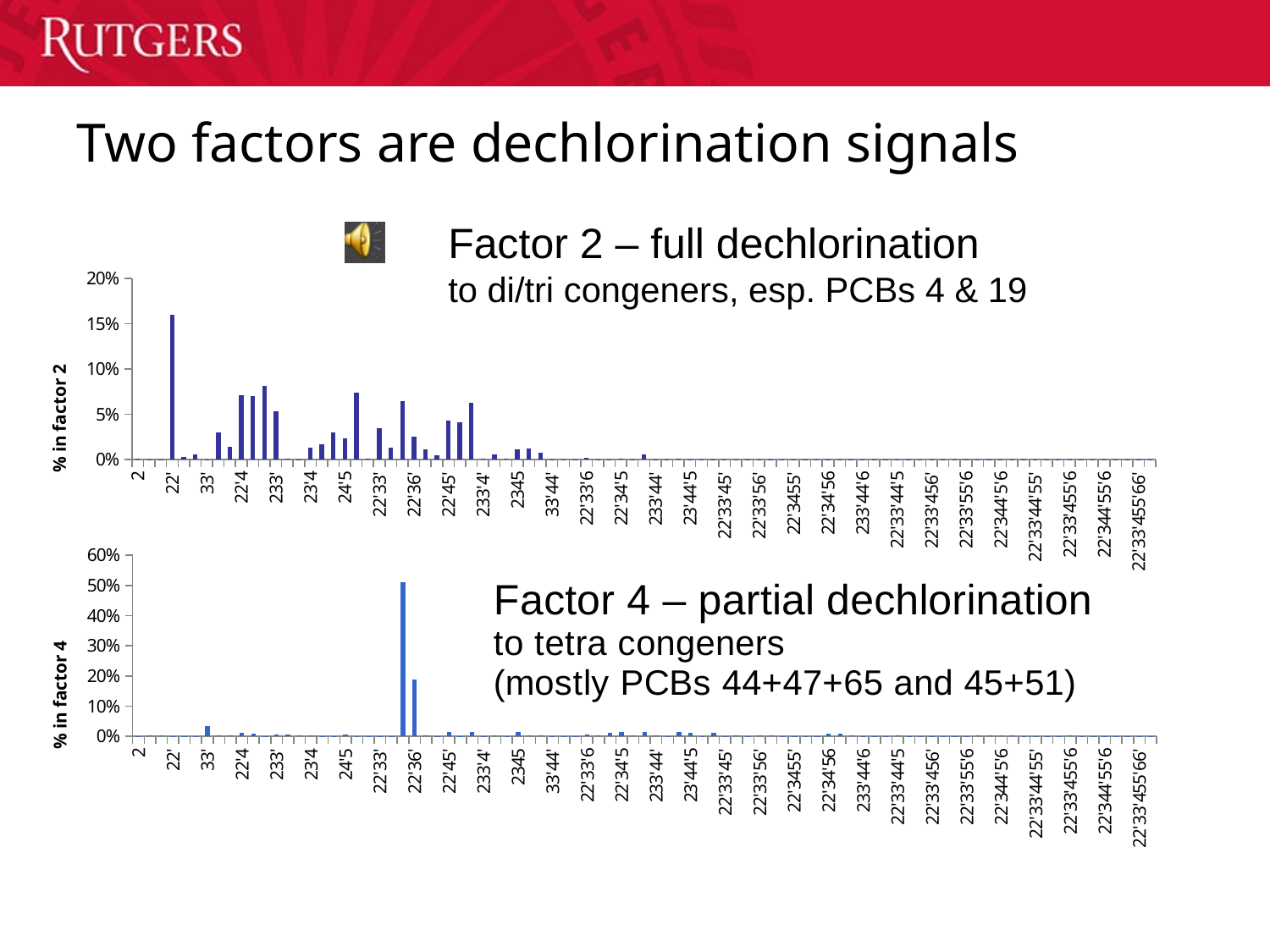
What type of chart is the top chart (% in factor 2)? bar chart In the top chart (% in factor 2), is the value for the category labelled 22' greater or less than 15%? greater What is the y-axis label of the top chart? % in factor 2 In the bottom chart (% in factor 4), what is the highest value shown on the y-axis? 60% In the bottom chart (% in factor 4), is the value for the category labelled 33' greater or less than 10%? less Which chart has the larger maximum value on its y-axis, the top chart (% in factor 2) or the bottom chart (% in factor 4)? the bottom chart (% in factor 4) In the bottom chart (% in factor 4), is the tallest bar greater or less than 40%? greater In the top chart (% in factor 2), what is the highest value shown on the y-axis? 20% What is the y-axis label of the bottom chart? % in factor 4 How many charts are shown on the slide? 2 What type of chart is the bottom chart (% in factor 4)? bar chart